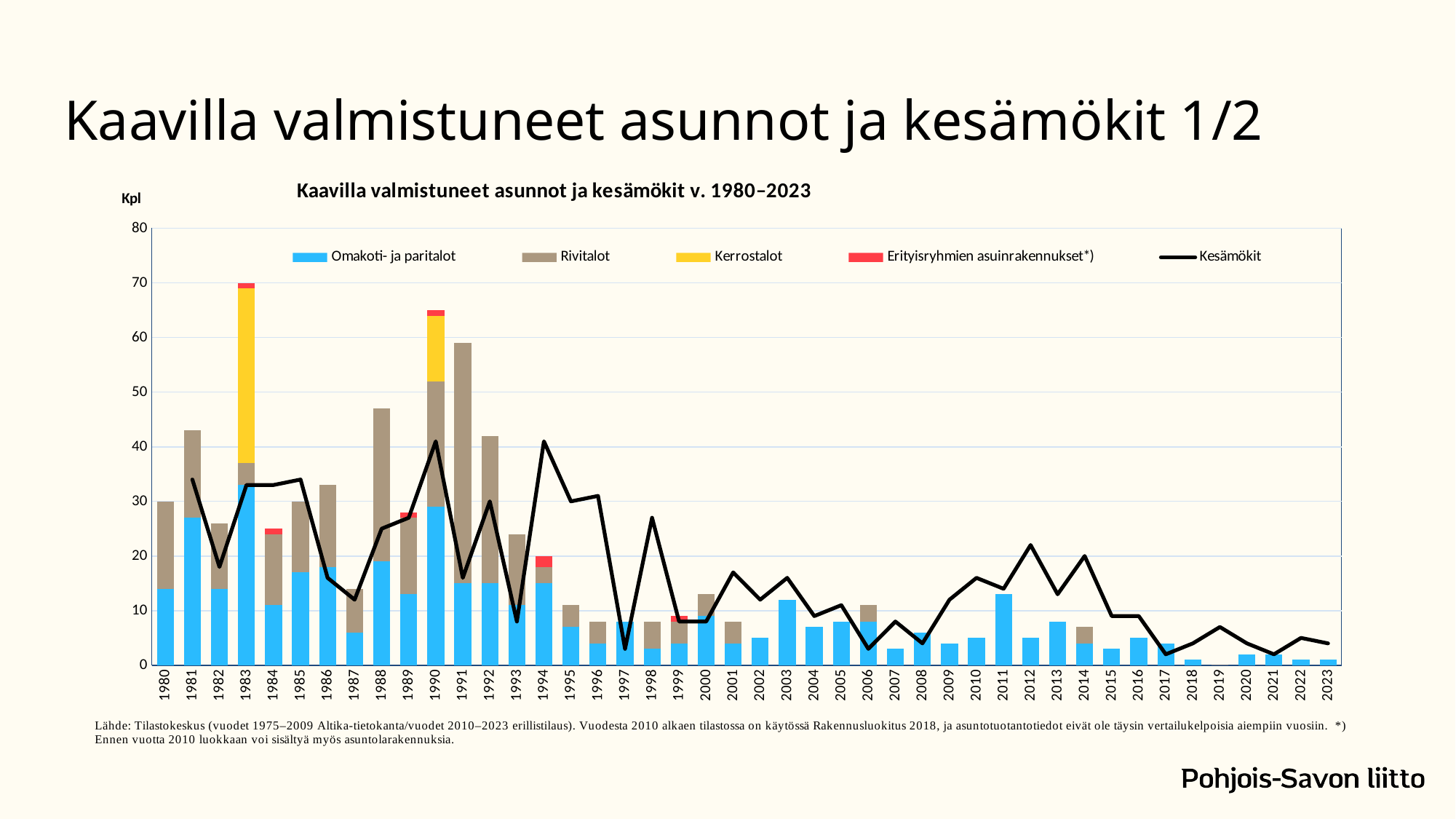
How many years are shown on the x axis? 44 Which series is drawn as a black line? Kesämökit Is the total of the stacked bar for 1983 greater or less than 60? greater What kind of chart is shown on the slide? Stacked bar chart with a line Is the Kesämökit value for 1997 greater or less than 10? less Is the total of the stacked bar for 1991 greater or less than 50? greater What is the title of the chart? Kaavilla valmistuneet asunnot ja kesämökit v. 1980–2023 How many series does the legend list? 5 Which stacked bar is taller, 1991 or 1992? 1991 Do the stacked bar totals generally rise or fall from 1991 to 2023? fall Which year has the tallest stacked bar? 1983